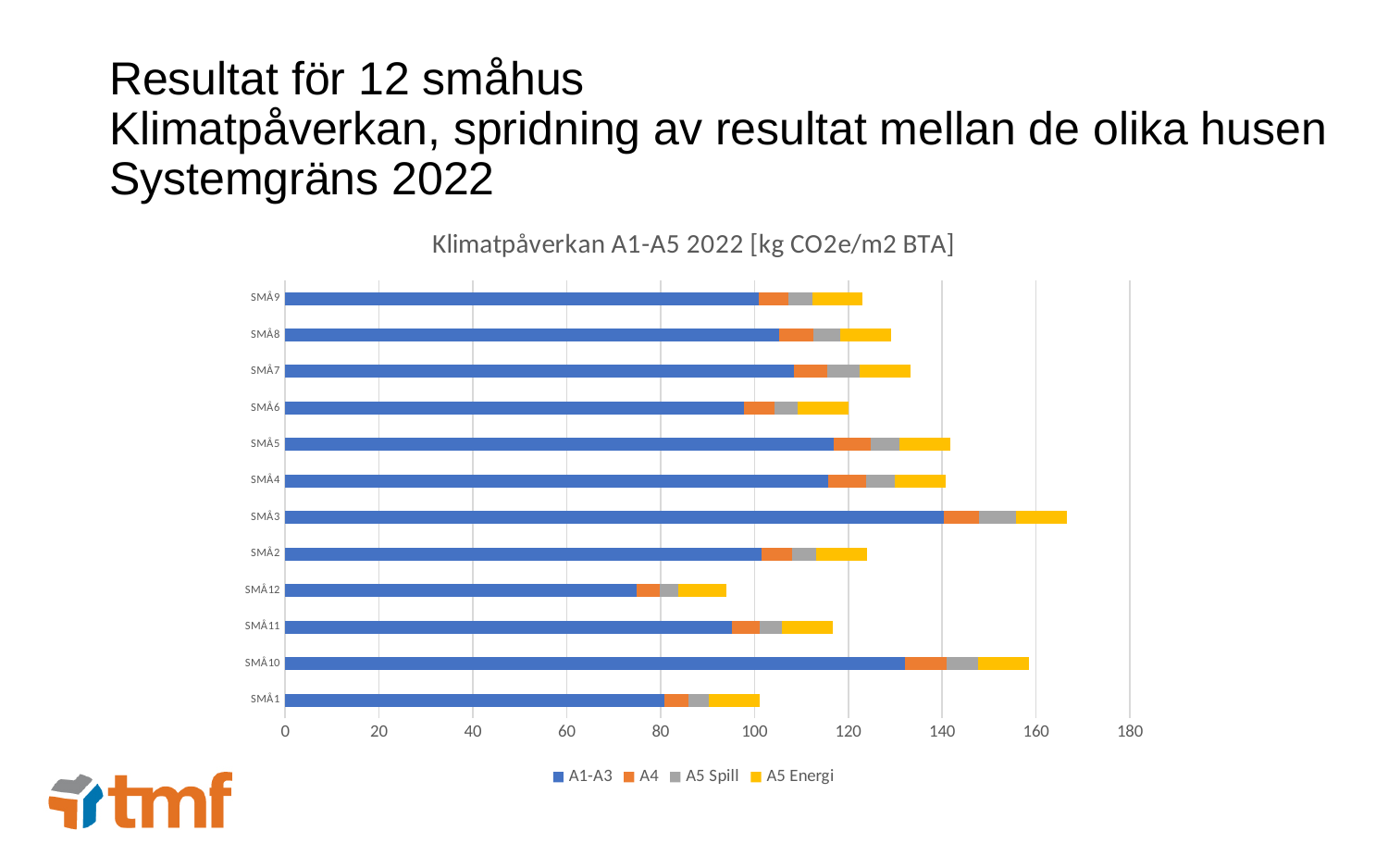
What kind of chart is shown on the slide? bar chart How many series does the legend list? 4 Is the total value for SMÅ7 greater or less than 120? greater Which house has the highest total climate impact in the chart? SMÅ3 Is the total value for SMÅ3 greater or less than 160? greater What is the title of the chart? Klimatpåverkan A1-A5 2022 [kg CO2e/m2 BTA] Is the total value for SMÅ12 greater or less than 100? less Which has the larger total value, SMÅ10 or SMÅ1? SMÅ10 How many categories (houses) are plotted in the chart? 12 Which series is shown in blue in the chart? A1-A3 Which house has the lowest total climate impact in the chart? SMÅ12